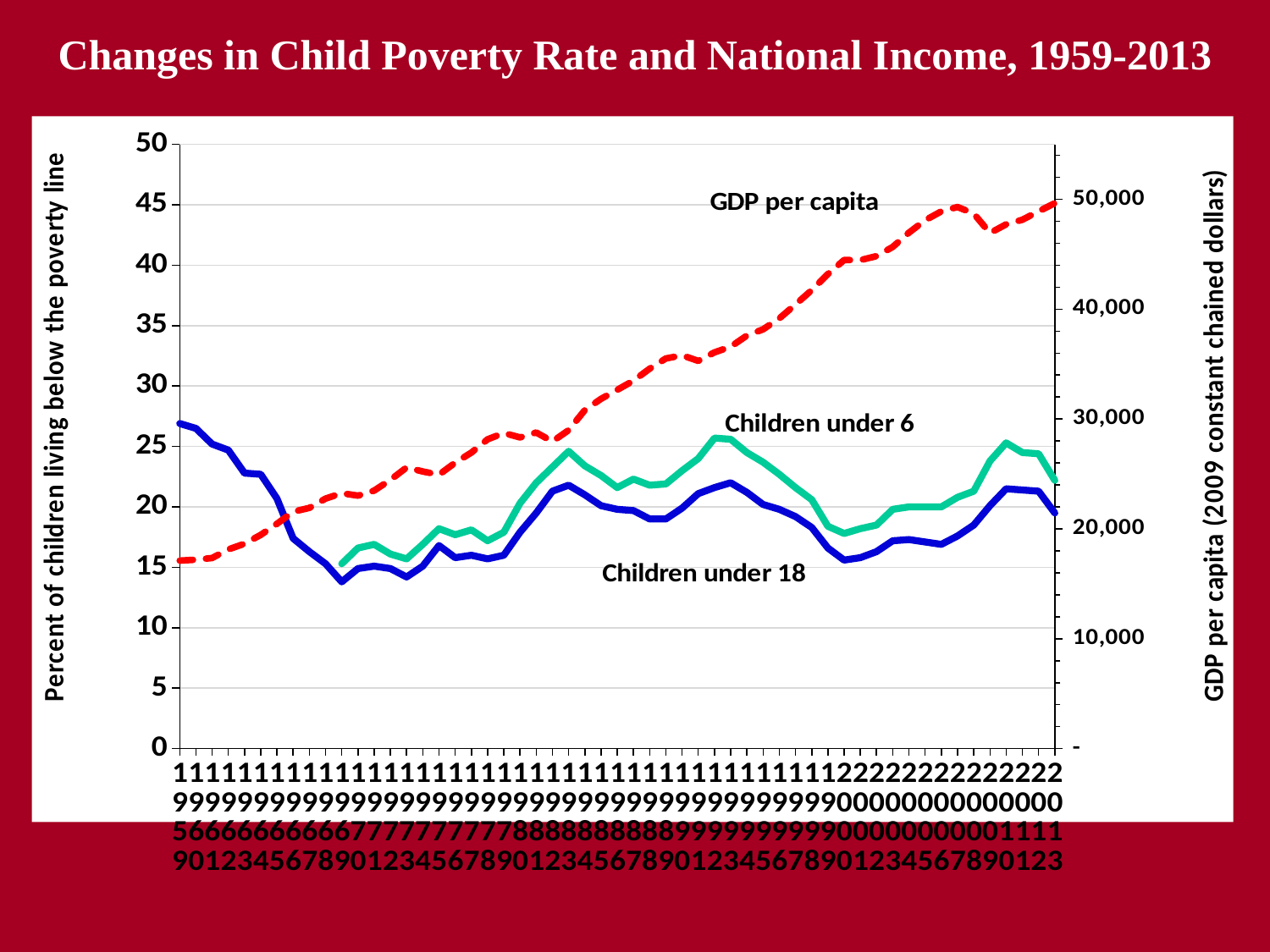
Is the value for Children under 18 in 1959 greater or less than 25? greater Which series is higher in 2010, Children under 6 or Children under 18? Children under 6 Does the GDP per capita series generally rise or fall from 1959 to 2013? rise How many data series are plotted on the chart? 3 What kind of chart is shown on the slide? line chart What is the title of the chart on the slide? Changes in Child Poverty Rate and National Income, 1959-2013 Is the value for Children under 18 in 1969 greater or less than 15? less Is the value for GDP per capita in 2013 greater or less than 40,000? greater Does the Children under 18 series rise or fall from 1959 to 1969? fall What is the label of the right-hand vertical axis? GDP per capita (2009 constant chained dollars)